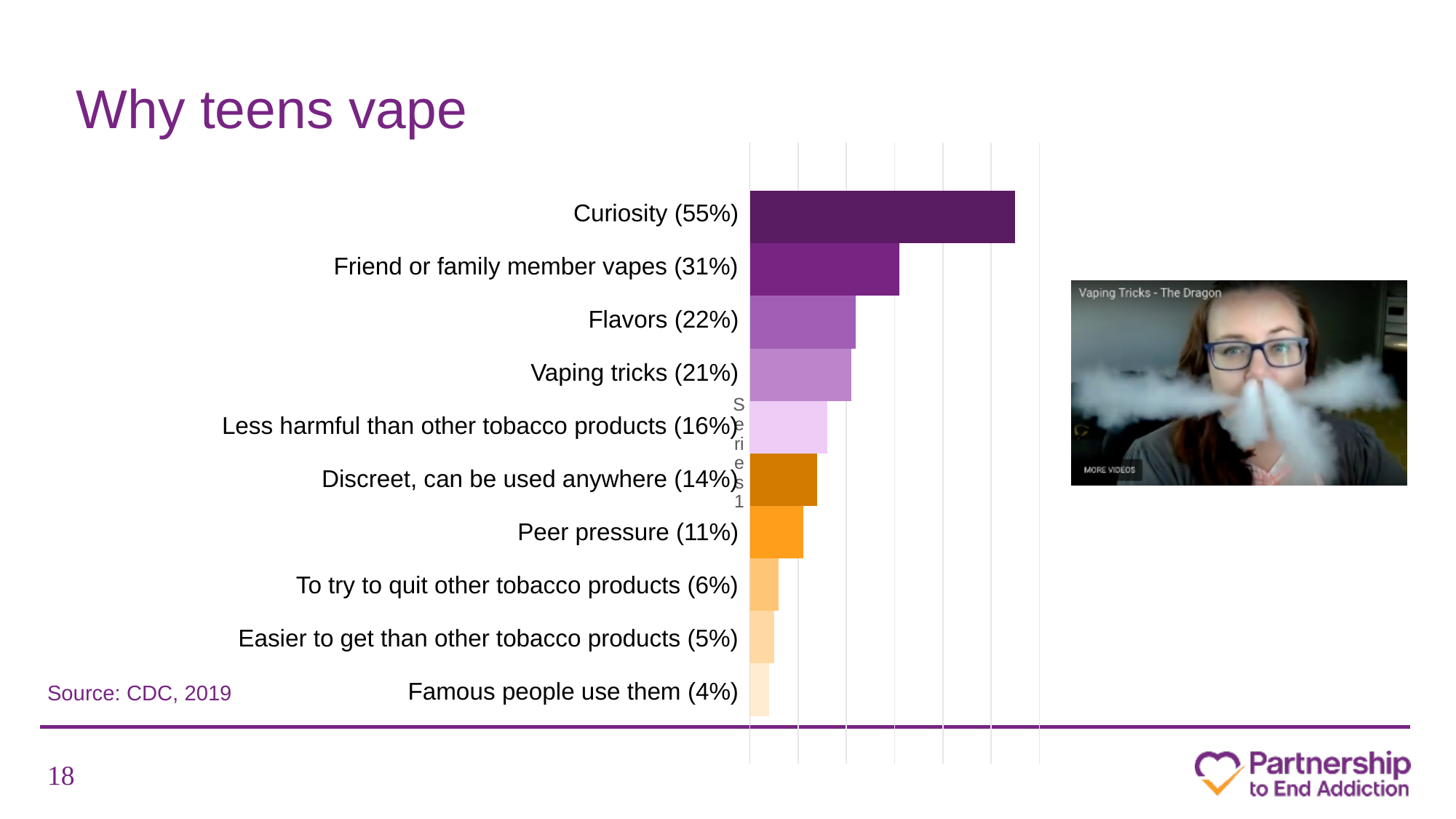
What is the title of the slide containing the chart? Why teens vape What percentage of teens cite curiosity as a reason for vaping? 55% What kind of chart is shown on the slide? Bar chart How many reasons are listed in the chart? 10 Which is larger: 'Discreet, can be used anywhere' or 'Peer pressure'? Discreet, can be used anywhere Which reason has the lowest percentage? Famous people use them What percentage is given for 'Less harmful than other tobacco products'? 16% What percentage is given for 'Flavors'? 22% What is the difference in percentage points between 'Curiosity' and 'Friend or family member vapes'? 24 Which reason has the highest percentage? Curiosity What is the difference in percentage points between 'Flavors' and 'Vaping tricks'? 1 What percentage is given for 'Peer pressure'? 11%